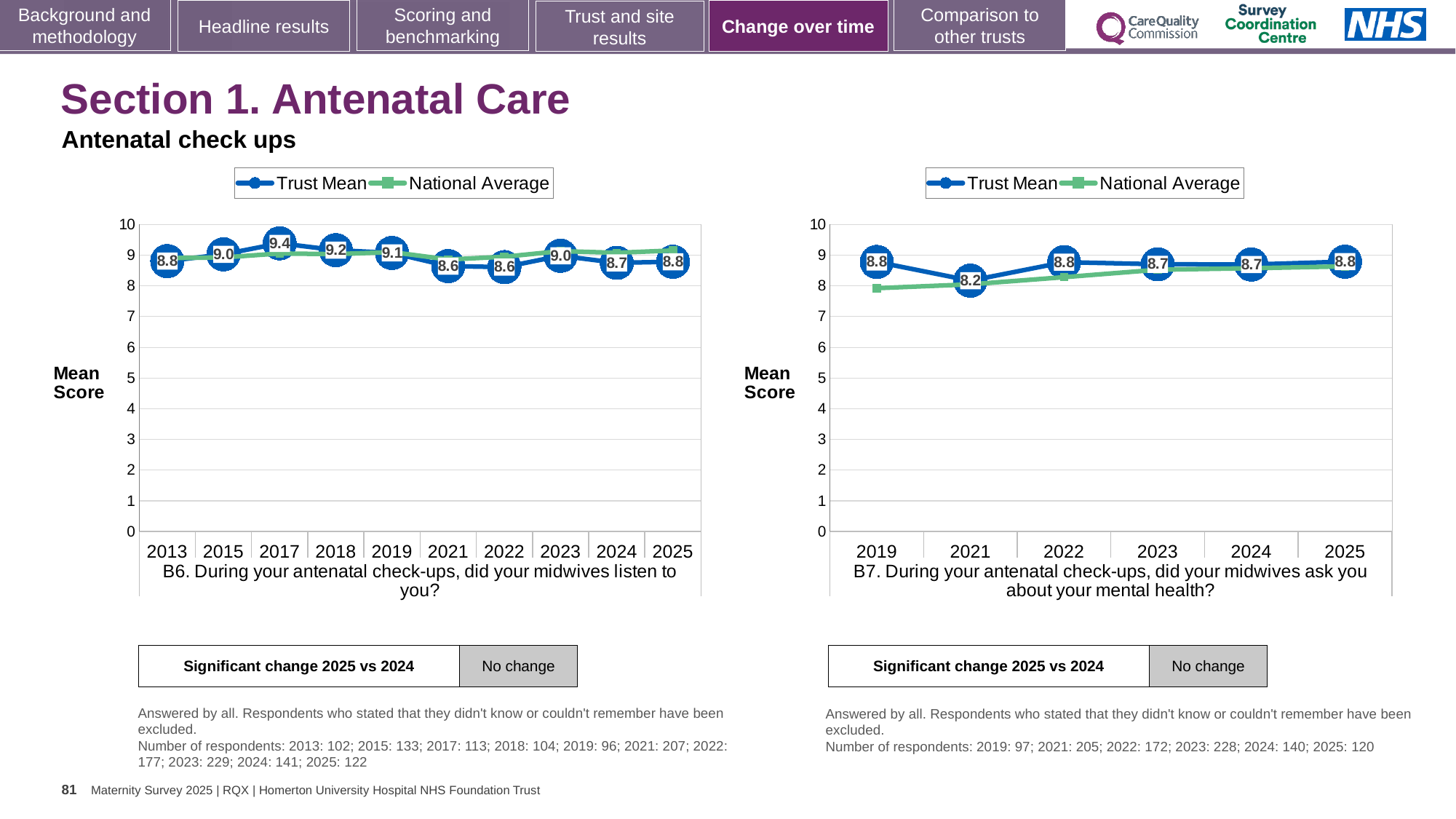
On the left chart (B6), what is the difference between the Trust Mean in 2017 and in 2022? 0.8 What kind of chart is the right chart (B7)? Line chart On the left chart (B6), which is larger, the Trust Mean for 2018 or for 2019? 2018 On the left chart (B6), what is the Trust Mean for 2017? 9.4 On the right chart (B7), what is the difference between the Trust Mean in 2019 and in 2021? 0.6 On the right chart (B7), how many years are plotted on the x axis? 6 On the left chart (B6), in which year is the Trust Mean highest? 2017 On the right chart (B7), what is the Trust Mean for 2021? 8.2 How many series does the legend of the right chart (B7) list? 2 On the left chart (B6), how many years are plotted on the x axis? 10 On the right chart (B7), in which year is the Trust Mean lowest? 2021 On the left chart (B6), what is the lowest Trust Mean value shown? 8.6